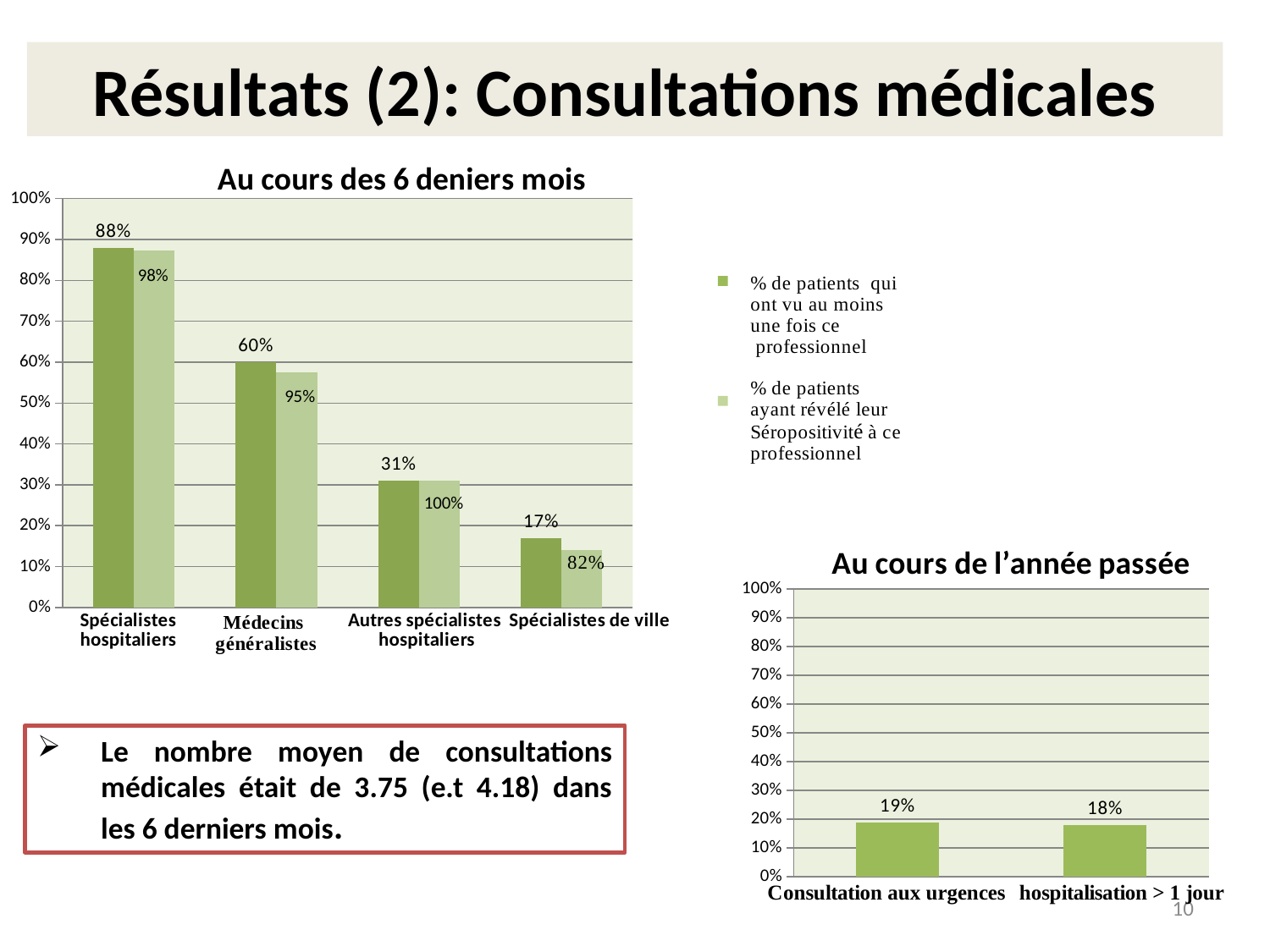
In the chart 'Au cours de l'année passée', what is the value for 'Consultation aux urgences'? 19% What type of chart is 'Au cours de l'année passée'? bar chart In the chart 'Au cours des 6 deniers mois', which category has the highest value for '% de patients qui ont vu au moins une fois ce professionnel'? Spécialistes hospitaliers In the chart 'Au cours des 6 deniers mois', do the values for '% de patients qui ont vu au moins une fois ce professionnel' rise or fall from left to right? fall In the chart 'Au cours des 6 deniers mois', what is the difference between the '% de patients qui ont vu au moins une fois ce professionnel' values for 'Spécialistes hospitaliers' and 'Médecins généralistes'? 28% In the chart 'Au cours des 6 deniers mois', what is the data label for 'Autres spécialistes hospitaliers' for the series '% de patients ayant révélé leur Séropositivité à ce professionnel'? 100% In the chart 'Au cours des 6 deniers mois', what is the value for 'Médecins généralistes' for the series '% de patients qui ont vu au moins une fois ce professionnel'? 60% In the chart 'Au cours de l'année passée', what is the value for 'hospitalisation > 1 jour'? 18% In the chart 'Au cours des 6 deniers mois', how many series does the legend list? 2 In the chart 'Au cours des 6 deniers mois', what percentage of patients saw a 'Spécialistes hospitaliers' at least once? 88% In the chart 'Au cours des 6 deniers mois', which category has the lowest value for '% de patients qui ont vu au moins une fois ce professionnel'? Spécialistes de ville In the chart 'Au cours des 6 deniers mois', how many categories are shown on the x axis? 4